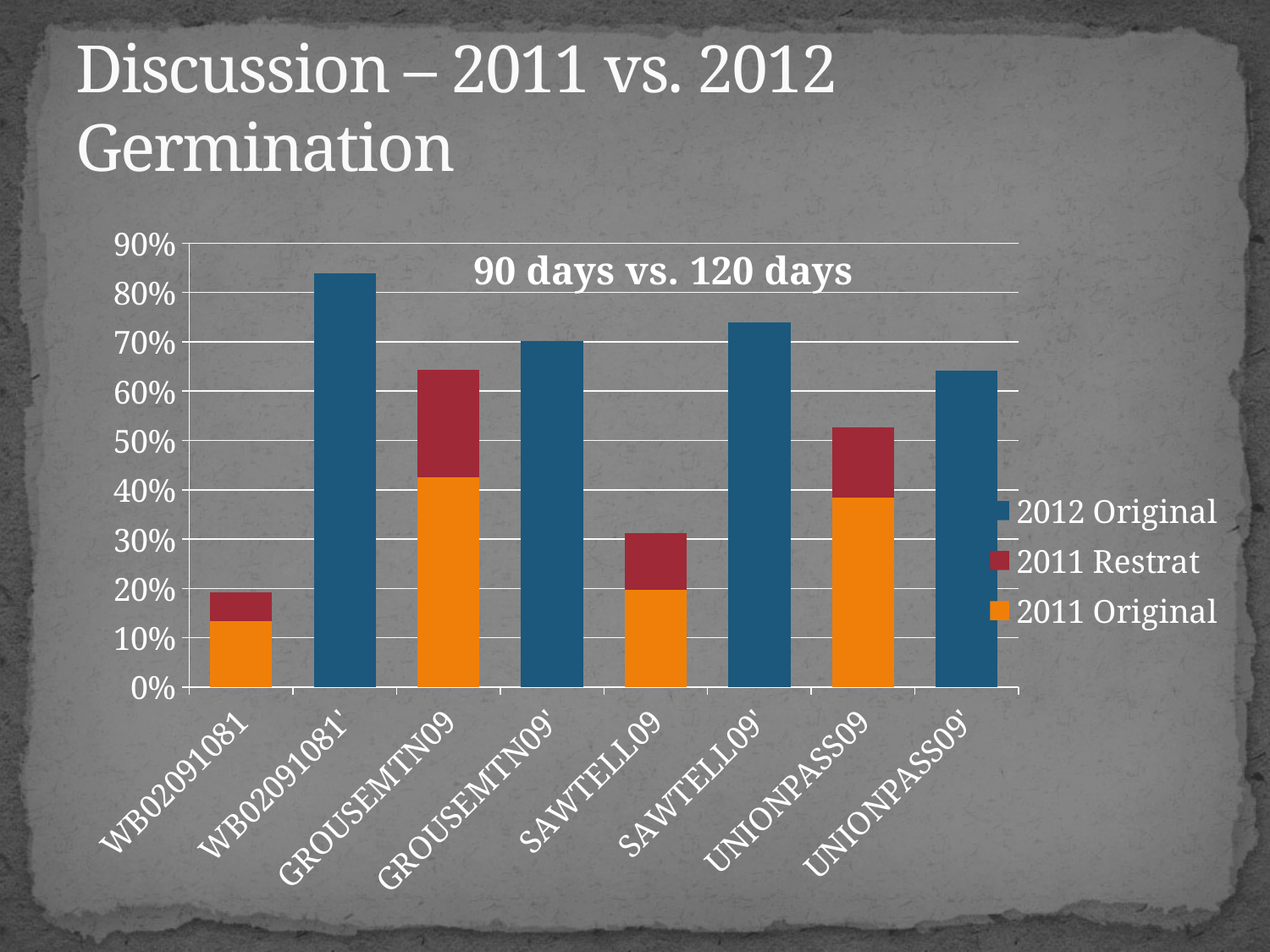
Which is larger, the bar for UNIONPASS09 or the bar for UNIONPASS09'? UNIONPASS09' Is the value for SAWTELL09' greater or less than 70%? greater Is the value for WB02091081' greater or less than 80%? greater What text is written inside the plot area at the top of the chart? 90 days vs. 120 days How many categories are shown on the x axis of the chart? 8 Which is larger, the bar for GROUSEMTN09 or the bar for GROUSEMTN09'? GROUSEMTN09' Which category has the tallest bar in the chart? WB02091081' What kind of chart is shown on the slide? bar chart How many series does the chart legend list? 3 Is the total stacked value for SAWTELL09 greater or less than 40%? less Which category has the shortest bar in the chart? WB02091081